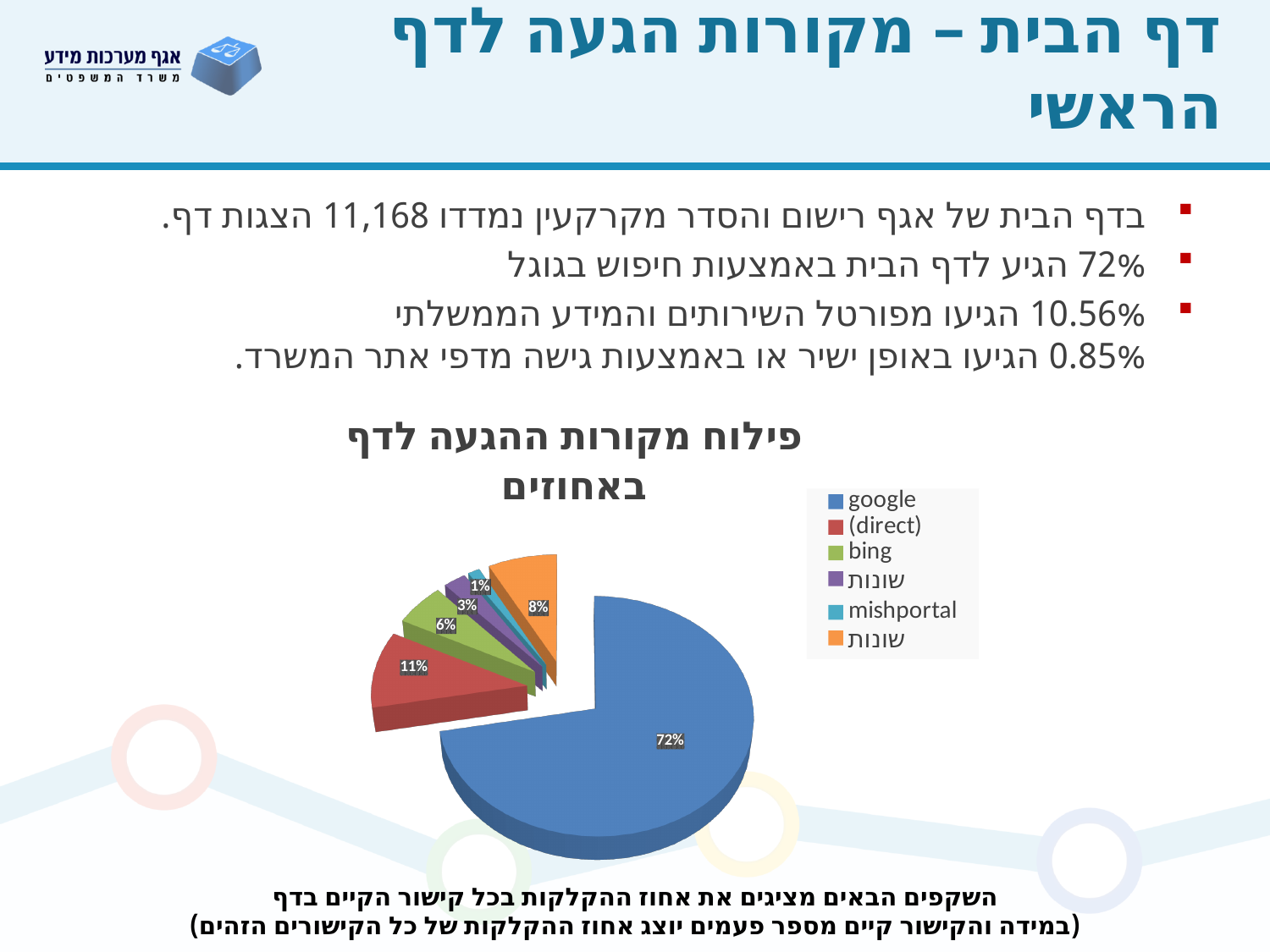
What share of the pie does google have? 72% What is the title of the chart? פילוח מקורות ההגעה לדף באחוזים What share of the pie does (direct) have? 11% What share of the pie does bing have? 6% Which category has the smallest slice of the pie? mishportal What is the difference in percentage points between the google slice and the (direct) slice? 61 Which is larger, the bing slice or the (direct) slice? (direct) What kind of chart is shown on the slide? pie chart How many slices does the pie chart have? 6 Which category has the largest slice of the pie? google How many entries does the chart's legend list? 6